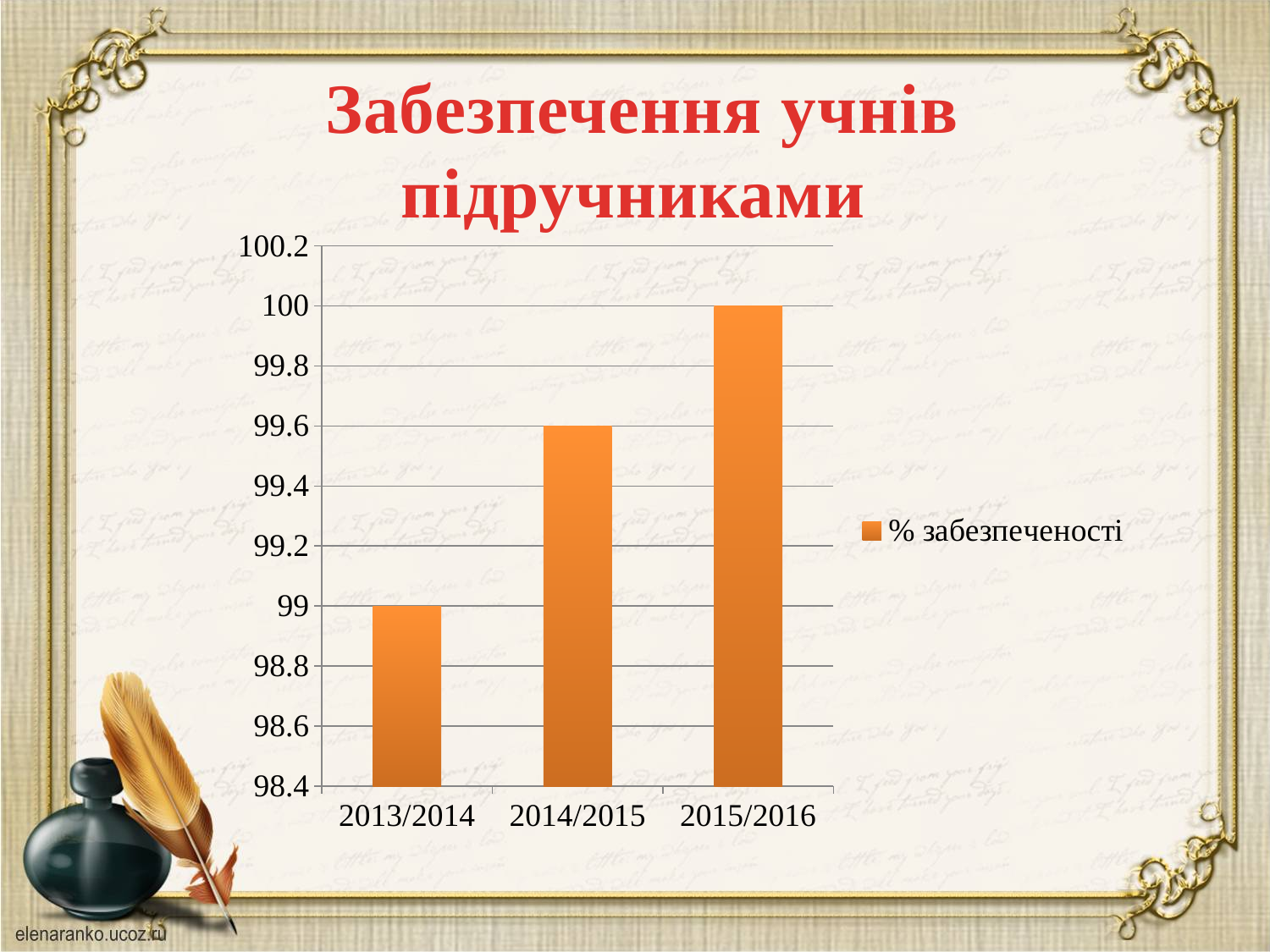
How many series does the legend list? 1 What kind of chart is shown on the slide? bar chart What is the value for 2013/2014? 99 What is the value for 2015/2016? 100 What is the difference between the values for 2015/2016 and 2013/2014? 1 What is the value for 2014/2015? 99.6 Which school year has the lowest value? 2013/2014 What is the legend entry for the series shown? % забезпеченості Do the values rise or fall from 2013/2014 to 2015/2016? rise Which is larger, the value for 2014/2015 or the value for 2013/2014? 2014/2015 How many categories (school years) are shown on the x axis? 3 Which school year has the highest value? 2015/2016